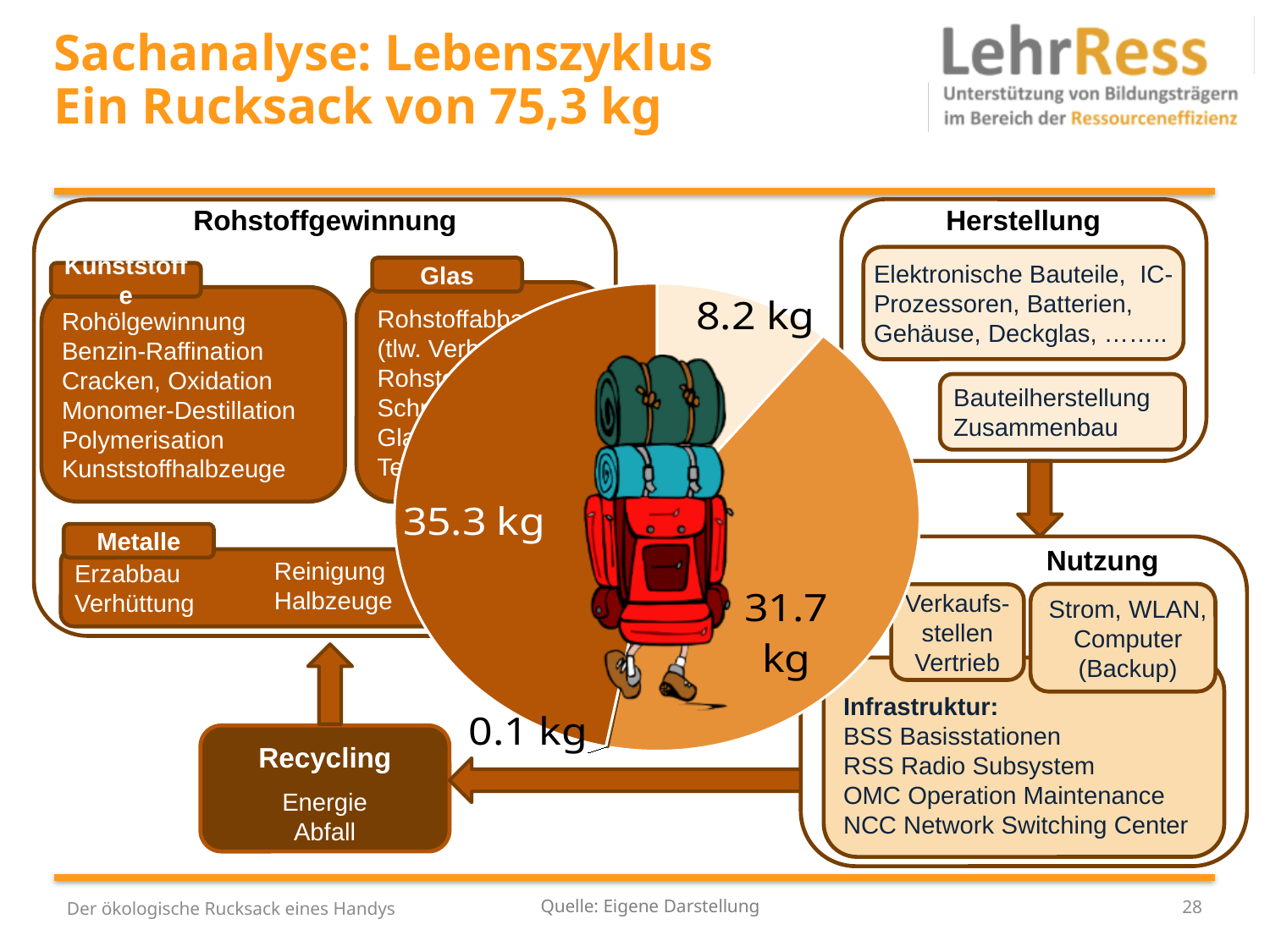
What is the total of all four slice values in the pie chart? 75.3 kg According to the slide title, how heavy is the 'Rucksack' (ecological backpack) in total? 75,3 kg What value is labelled on the light-coloured slice at the top right of the pie chart, next to the Herstellung box? 8.2 kg What is the difference between the 31.7 kg slice and the 8.2 kg slice? 23.5 kg What kind of chart is shown in the centre of the slide? pie chart What is the value of the smallest slice of the pie chart? 0.1 kg How many slices does the pie chart have? 4 What is the value of the largest slice of the pie chart? 35.3 kg Which is larger: the slice labelled 31.7 kg or the slice labelled 8.2 kg? 31.7 kg What value is labelled on the thin slice at the bottom of the pie chart, next to the Recycling box? 0.1 kg What is the difference between the 35.3 kg slice and the 31.7 kg slice? 3.6 kg What is the difference between the 35.3 kg slice and the 8.2 kg slice? 27.1 kg